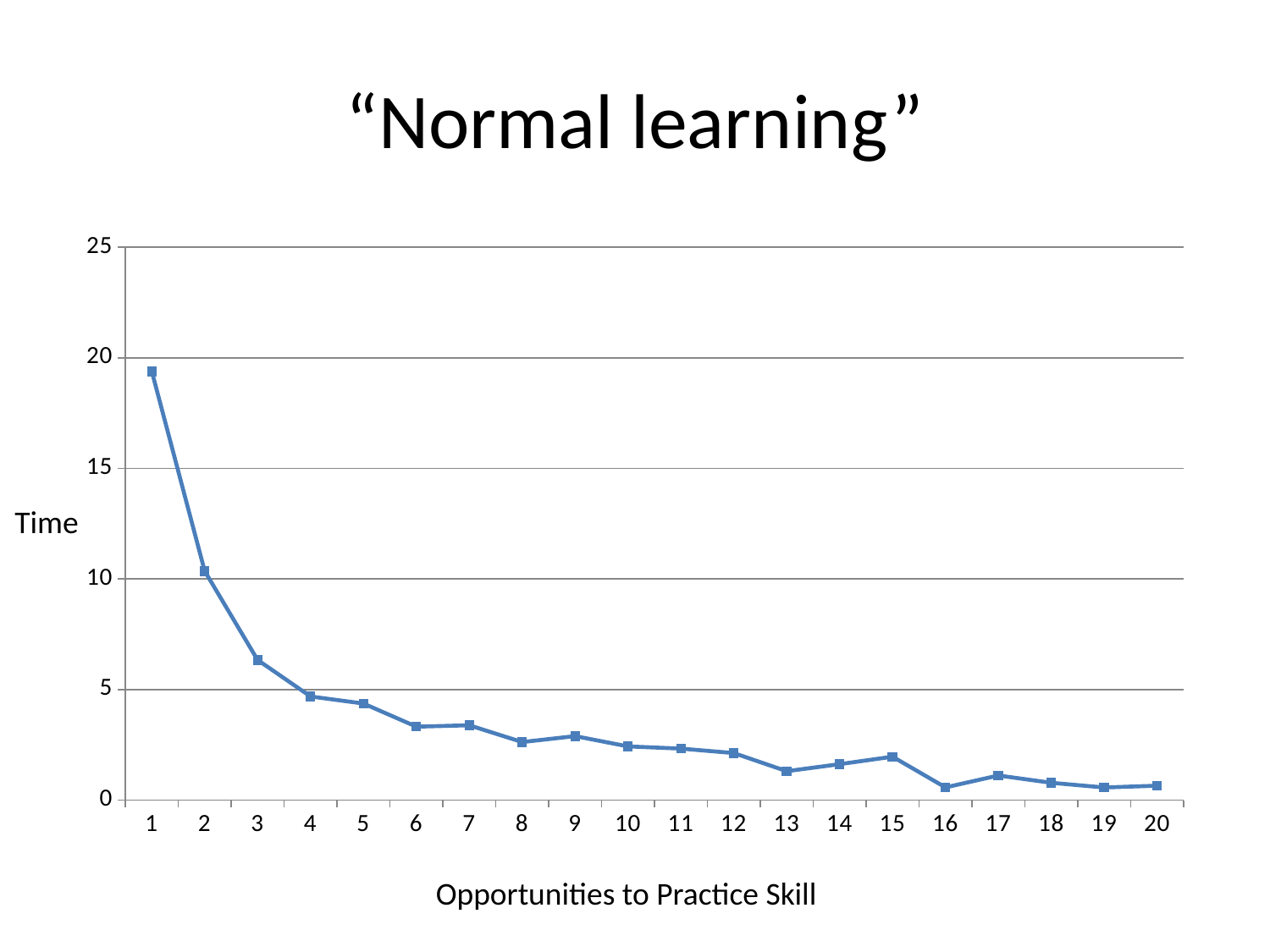
Is the value for opportunity 3 greater or less than 5? greater Which has the larger value, opportunity 13 or opportunity 15? opportunity 15 Do the values generally rise or fall as the number of opportunities to practice skill increases? fall Is the value for opportunity 1 greater or less than 15? greater What is the title of the chart? "Normal learning" How many data points are plotted on the line? 20 Which has the larger value, opportunity 1 or opportunity 2? opportunity 1 Is the value for opportunity 1 greater or less than 20? less What kind of chart is shown on the slide? line chart What is the label of the x axis? Opportunities to Practice Skill At which opportunity to practice skill is the time highest? 1